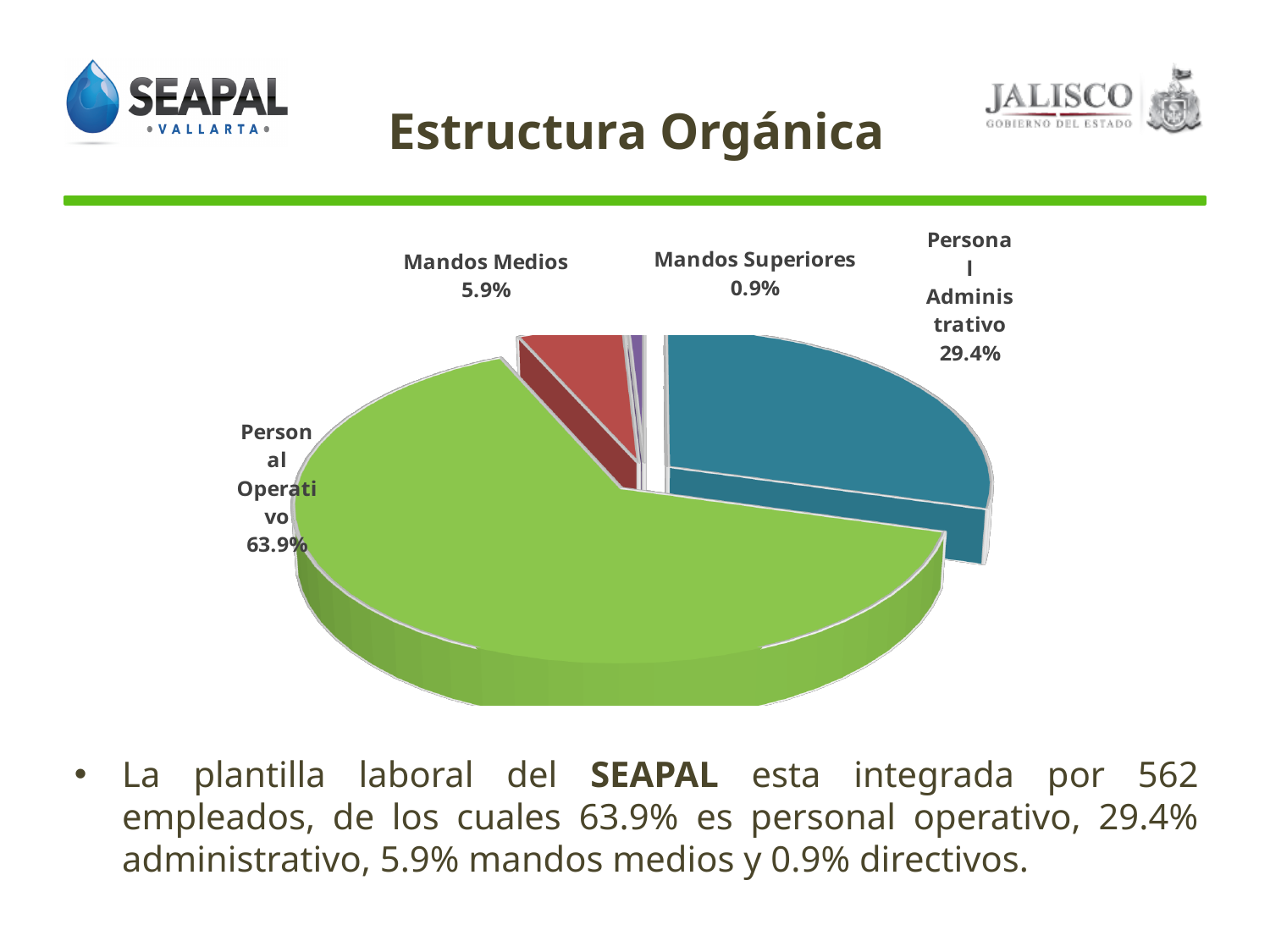
What colour is the Personal Operativo slice? Green Which category has the smallest share of the pie? Mandos Superiores What is the difference in percentage points between Personal Operativo and Personal Administrativo? 34.5 Which is larger, Mandos Medios or Mandos Superiores? Mandos Medios What percentage does the Mandos Medios slice represent? 5.9% What percentage does the Mandos Superiores slice represent? 0.9% What kind of chart is shown on the slide? Pie chart Which category has the largest share of the pie? Personal Operativo What percentage does the Personal Administrativo slice represent? 29.4% What percentage does the Personal Operativo slice represent? 63.9% How many slices does the pie chart have? 4 What is the difference in percentage points between Mandos Medios and Mandos Superiores? 5.0